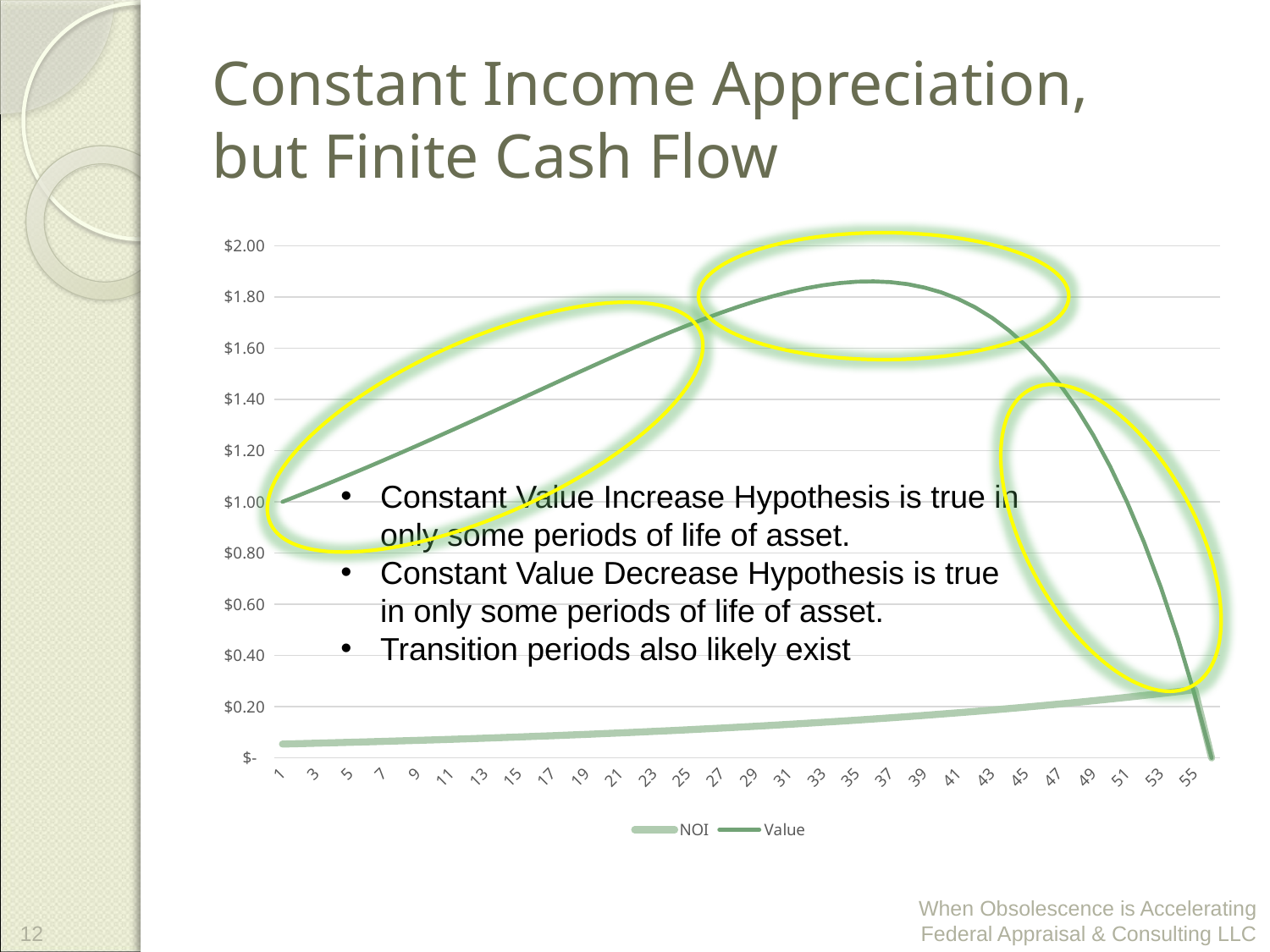
What are the two series named in the chart legend? NOI and Value Which series reaches the highest point on the chart? Value How many series does the chart legend list? 2 Is the Value at period 55 greater or less than $0.40? less Does the NOI series rise or fall along the x axis? rise What kind of chart is shown on the slide? line chart Is the NOI at period 1 greater or less than $0.20? less What is the Value at period 1? $1.00 At period 1, which series is higher, NOI or Value? Value Is the Value at period 35 greater or less than $1.60? greater At period 55, which series is higher, NOI or Value? NOI